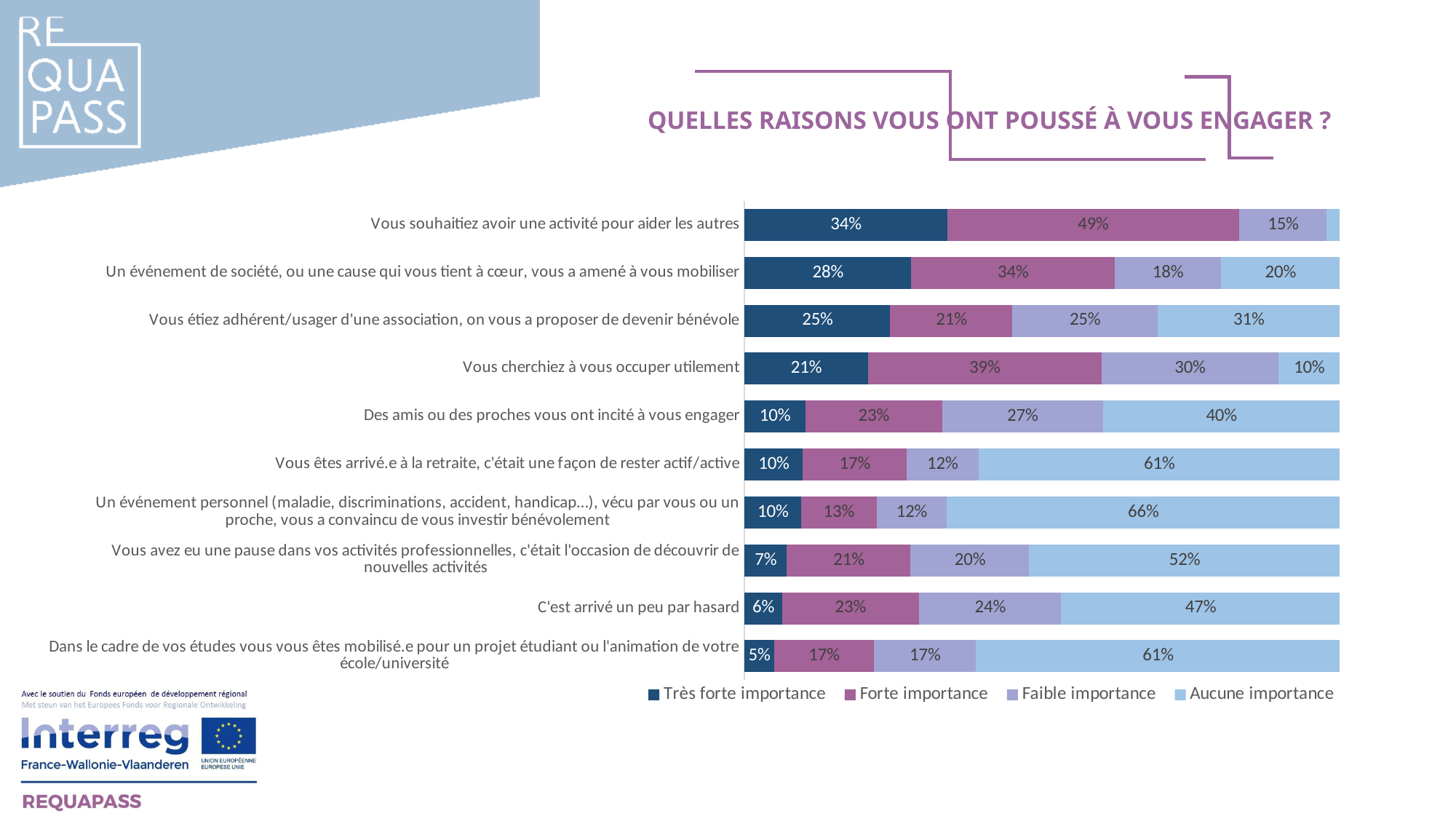
What is the difference between the 'Aucune importance' values for 'Vous êtes arrivé.e à la retraite, c'était une façon de rester actif/active' and 'Des amis ou des proches vous ont incité à vous engager'? 21% What is the 'Très forte importance' value for 'Vous souhaitiez avoir une activité pour aider les autres'? 34% Which category has the highest 'Très forte importance' value? Vous souhaitiez avoir une activité pour aider les autres What is the 'Aucune importance' value for 'Un événement personnel (maladie, discriminations, accident, handicap…), vécu par vous ou un proche, vous a convaincu de vous investir bénévolement'? 66% What is the 'Forte importance' value for 'Vous cherchiez à vous occuper utilement'? 39% Which category has the lowest 'Très forte importance' value? Dans le cadre de vos études vous vous êtes mobilisé.e pour un projet étudiant ou l'animation de votre école/université What type of chart is shown on the slide? Stacked bar chart What is the title of the chart? QUELLES RAISONS VOUS ONT POUSSÉ À VOUS ENGAGER ? What is the total of the stacked bar for 'Vous étiez adhérent/usager d'une association, on vous a proposer de devenir bénévole'? 102% How many categories (reasons) are plotted in the chart? 10 How many series does the legend list? 4 Which is larger: the 'Faible importance' value for 'Vous cherchiez à vous occuper utilement' or for 'C'est arrivé un peu par hasard'? Vous cherchiez à vous occuper utilement